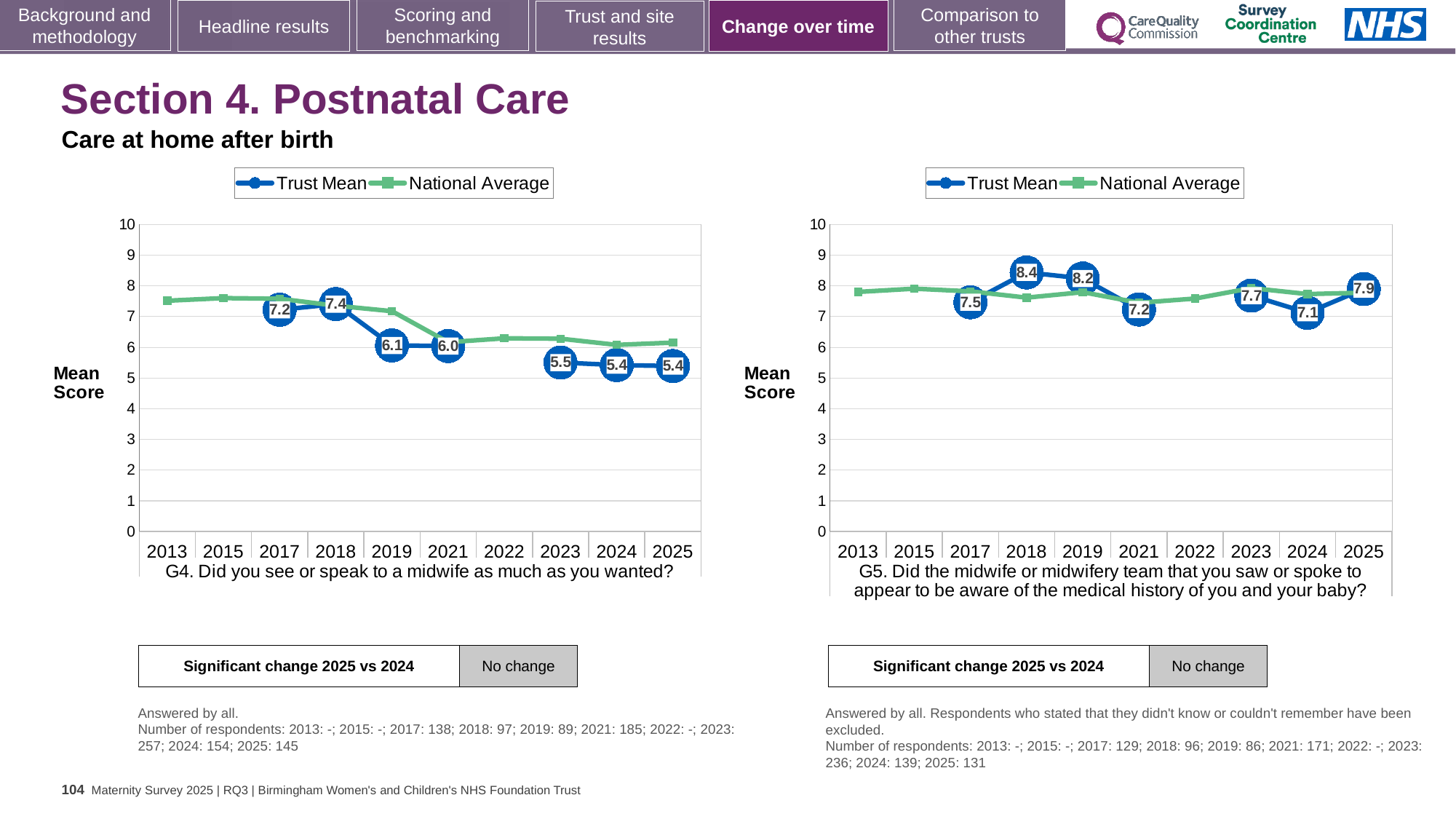
What kind of chart is the G4 chart (left)? line chart How many series does the legend of the G5 chart (right) list? 2 In the G4 chart (left), does the Trust Mean rise or fall from 2017 to 2025? fall In the G4 chart (left), is the National Average for 2013 greater or less than 7? greater In the G4 chart (left), what is the Trust Mean for 2018? 7.4 In the G5 chart (right), which is larger, the Trust Mean for 2019 or for 2021? 2019 In the G4 chart (left), what is the difference between the Trust Mean in 2018 and in 2025? 2.0 In the G5 chart (right), which year has the lowest Trust Mean? 2024 In the G5 chart (right), what is the difference between the Trust Mean in 2025 and in 2024? 0.8 In the G4 chart (left), which year has the highest Trust Mean? 2018 In the G4 chart (left), what is the Trust Mean for 2025? 5.4 In the G5 chart (right), what is the Trust Mean for 2018? 8.4